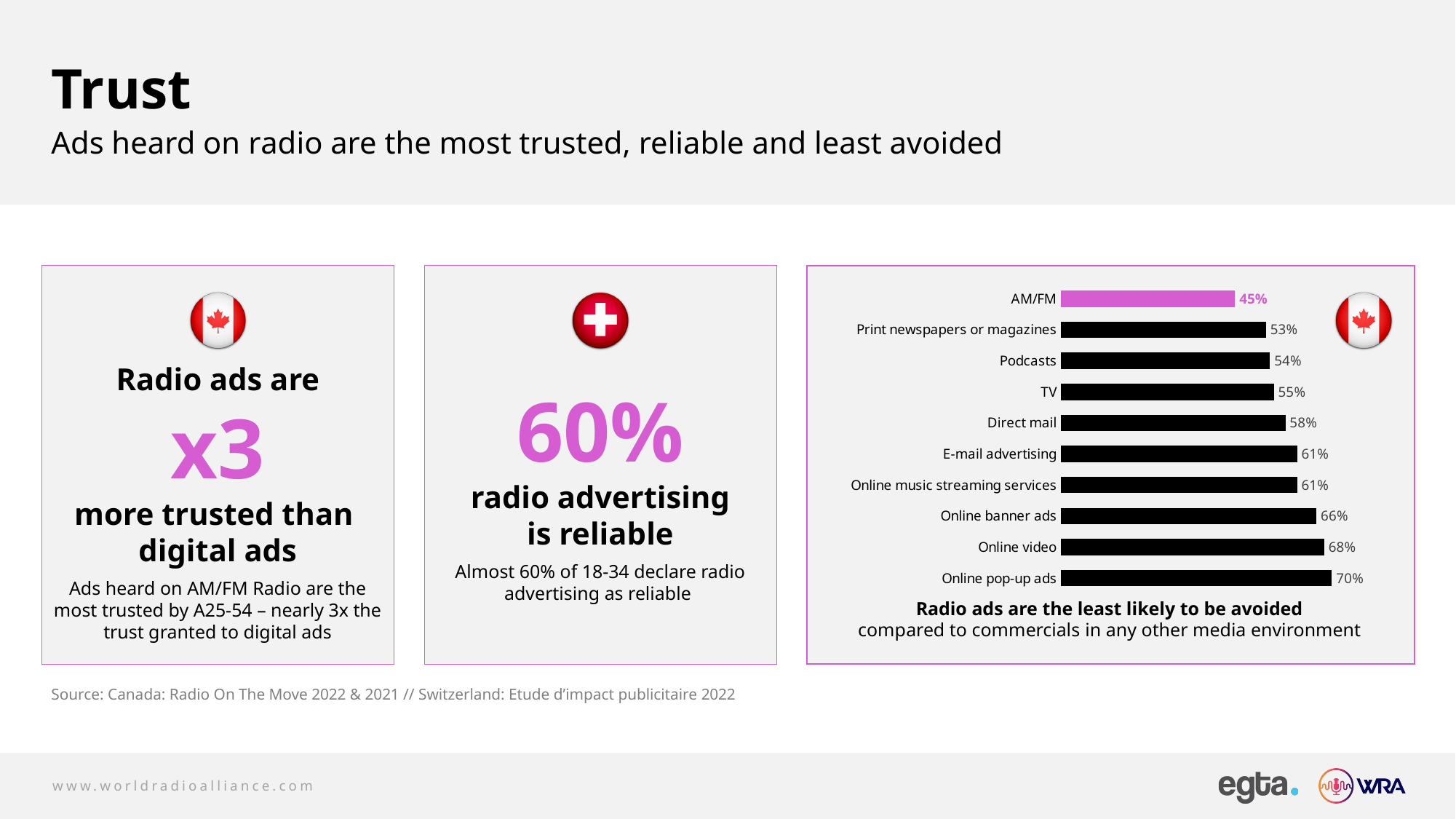
What is the value for AM/FM in the bar chart? 45% What is the difference between the values for Online pop-up ads and AM/FM in the bar chart? 25% What kind of chart is shown on the right of the slide? Bar chart Which has a larger value in the bar chart, Online video or Online banner ads? Online video What is the value for Direct mail in the bar chart? 58% Which category has the lowest value in the bar chart? AM/FM What is the value for Online pop-up ads in the bar chart? 70% Which category has the highest value in the bar chart? Online pop-up ads Which bar in the chart is highlighted in a different colour from the others? AM/FM What is the value for Podcasts in the bar chart? 54% How many categories are shown in the bar chart? 10 What is the difference between the values for TV and Print newspapers or magazines in the bar chart? 2%